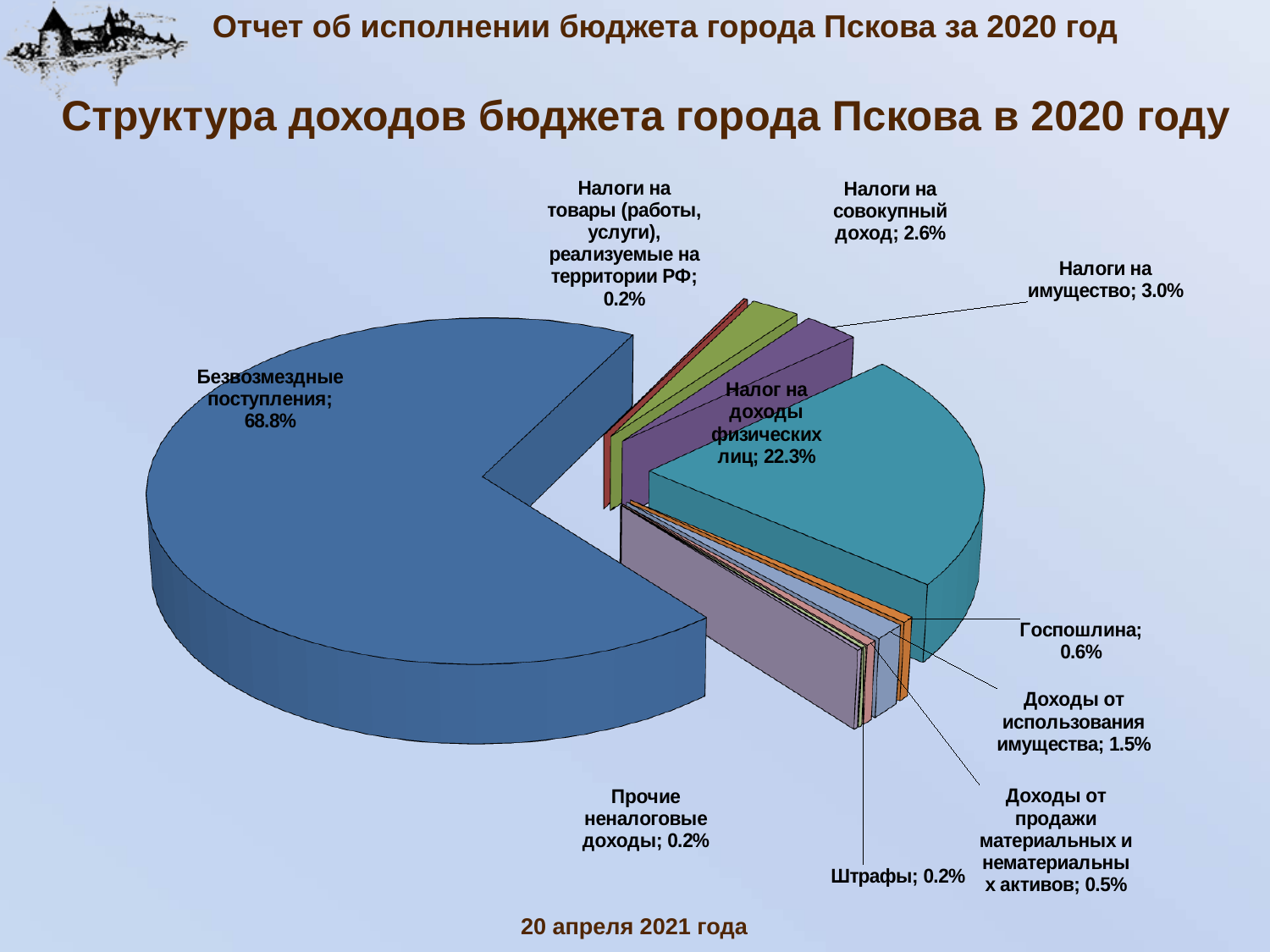
What is the difference between the shares of Безвозмездные поступления and Налог на доходы физических лиц? 46.5% What is the value shown for Госпошлина? 0.6% What share of the pie is labelled for Безвозмездные поступления? 68.8% How many categories (slices) are labelled on the pie chart? 10 Which is larger: Налоги на совокупный доход or Налоги на имущество? Налоги на имущество What is the title of the chart on the slide? Структура доходов бюджета города Пскова в 2020 году What is the value shown for Налоги на имущество? 3.0% What is the value shown for Налог на доходы физических лиц? 22.3% What is the value shown for Доходы от использования имущества? 1.5% What is the value shown for Доходы от продажи материальных и нематериальных активов? 0.5% Which category has the largest share of the pie? Безвозмездные поступления What kind of chart is shown on the slide? Pie chart